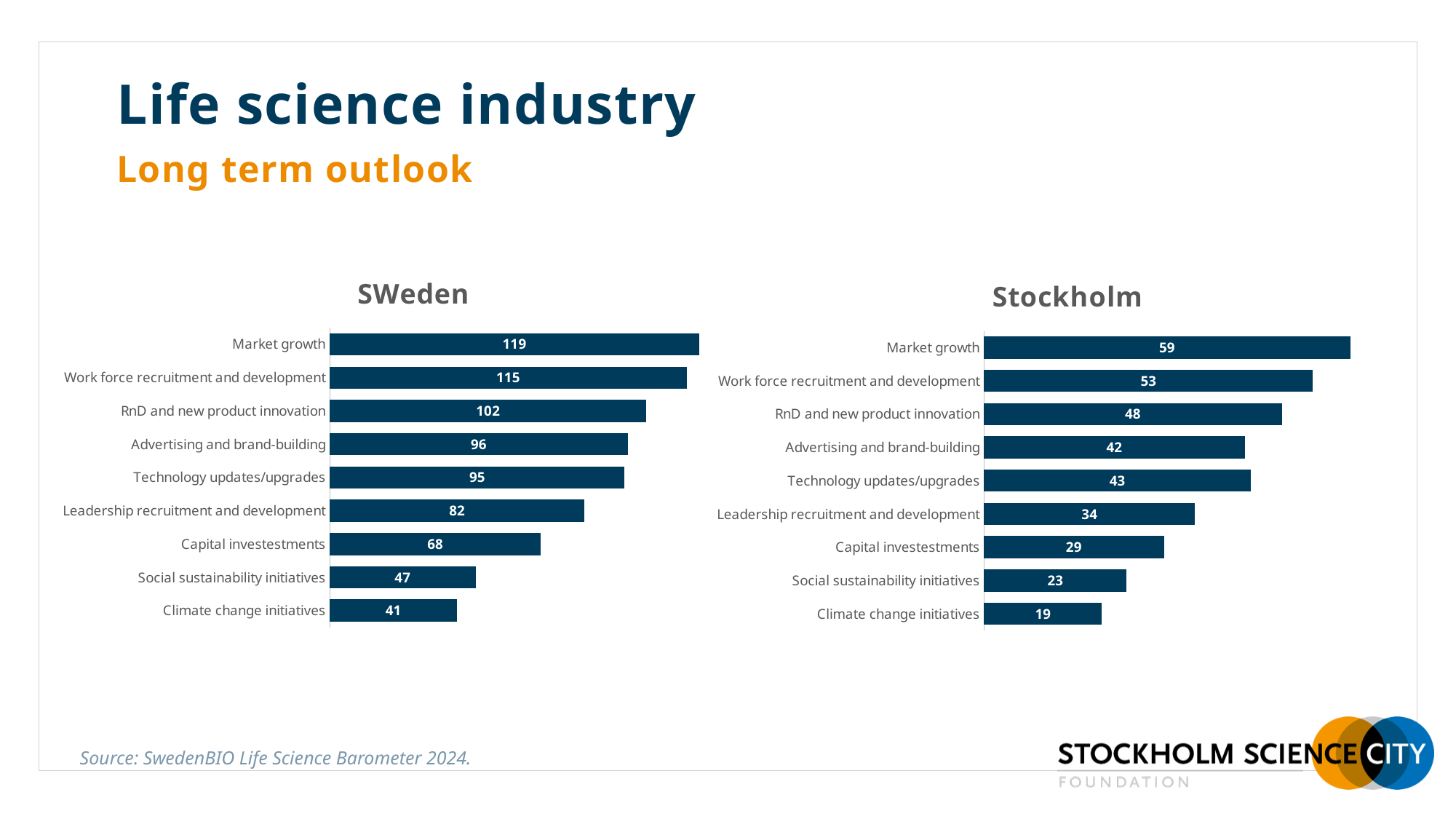
In the Stockholm chart, which is larger: Advertising and brand-building or Technology updates/upgrades? Technology updates/upgrades In the SWeden chart, what is the value for Market growth? 119 What type of chart is the Stockholm chart? Bar chart In the SWeden chart, what is the difference between Market growth and Work force recruitment and development? 4 In the Stockholm chart, what is the value for Technology updates/upgrades? 43 In the Stockholm chart, which category has the highest value? Market growth What is the title of the chart on the left side of the slide? SWeden In the Stockholm chart, what is the value for Capital investestments? 29 How many categories are shown in the SWeden chart? 9 In the SWeden chart, which category has the lowest value? Climate change initiatives In the SWeden chart, which is larger: Leadership recruitment and development or Capital investestments? Leadership recruitment and development In the Stockholm chart, what is the difference between RnD and new product innovation and Climate change initiatives? 29